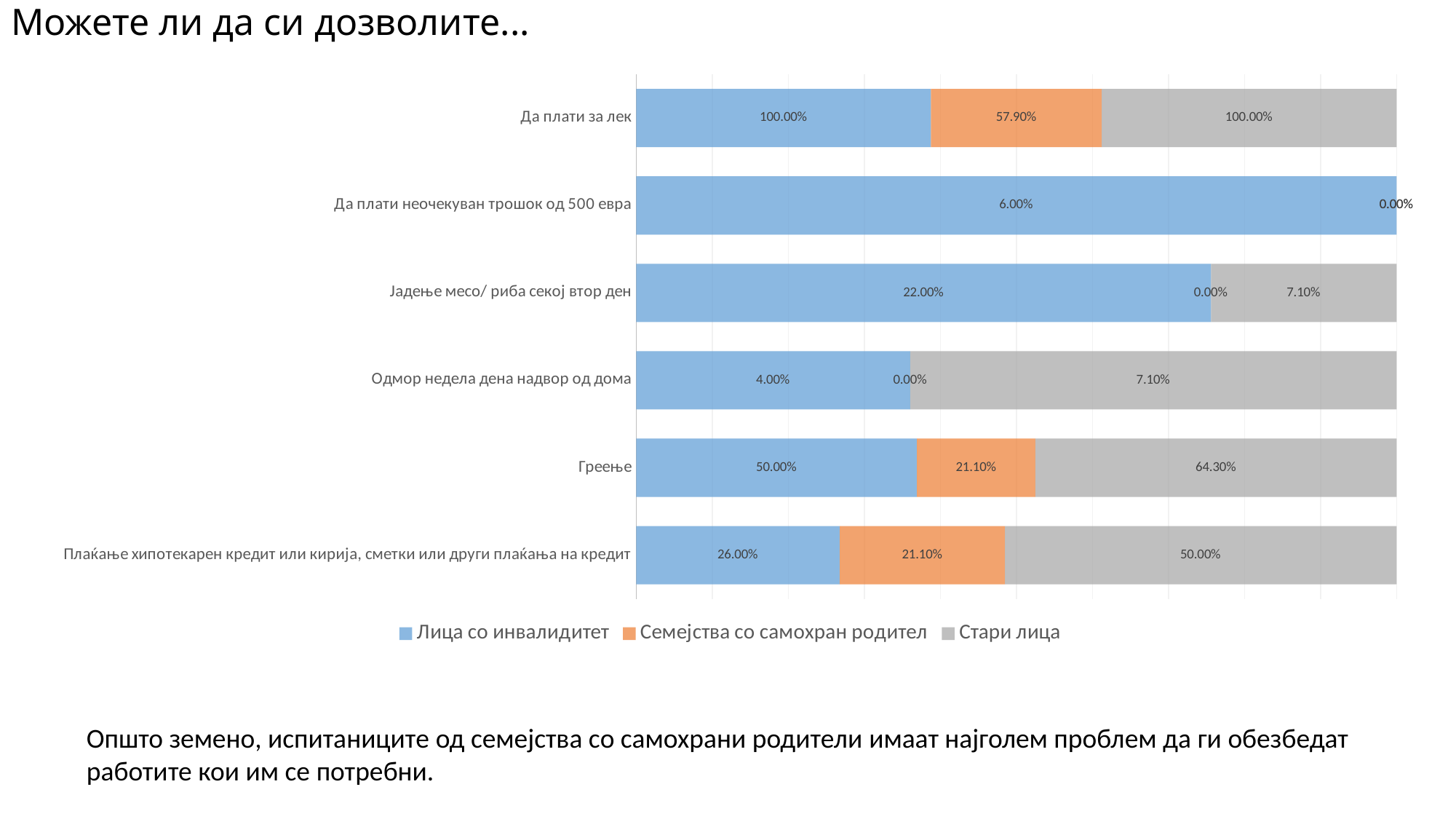
In the category Плаќање хипотекарен кредит или кирија, сметки или други плаќања на кредит, which is larger: the value for Стари лица or for Семејства со самохран родител? Стари лица What is the value for Стари лица in the category Греење? 64.30% Which category has the highest value for Семејства со самохран родител? Да плати за лек What kind of chart is shown on the slide? Stacked bar chart What is the difference between the Стари лица and Лица со инвалидитет values in the category Греење? 14.30% What is the title of the slide? Можете ли да си дозволите... What is the value for Стари лица in the category Одмор недела дена надвор од дома? 7.10% What is the value for Лица со инвалидитет in the category Греење? 50.00% How many series does the legend list? 3 What is the value for Лица со инвалидитет in the category Плаќање хипотекарен кредит или кирија, сметки или други плаќања на кредит? 26.00% How many categories are shown on the chart? 6 What is the value for Семејства со самохран родител in the category Да плати за лек? 57.90%